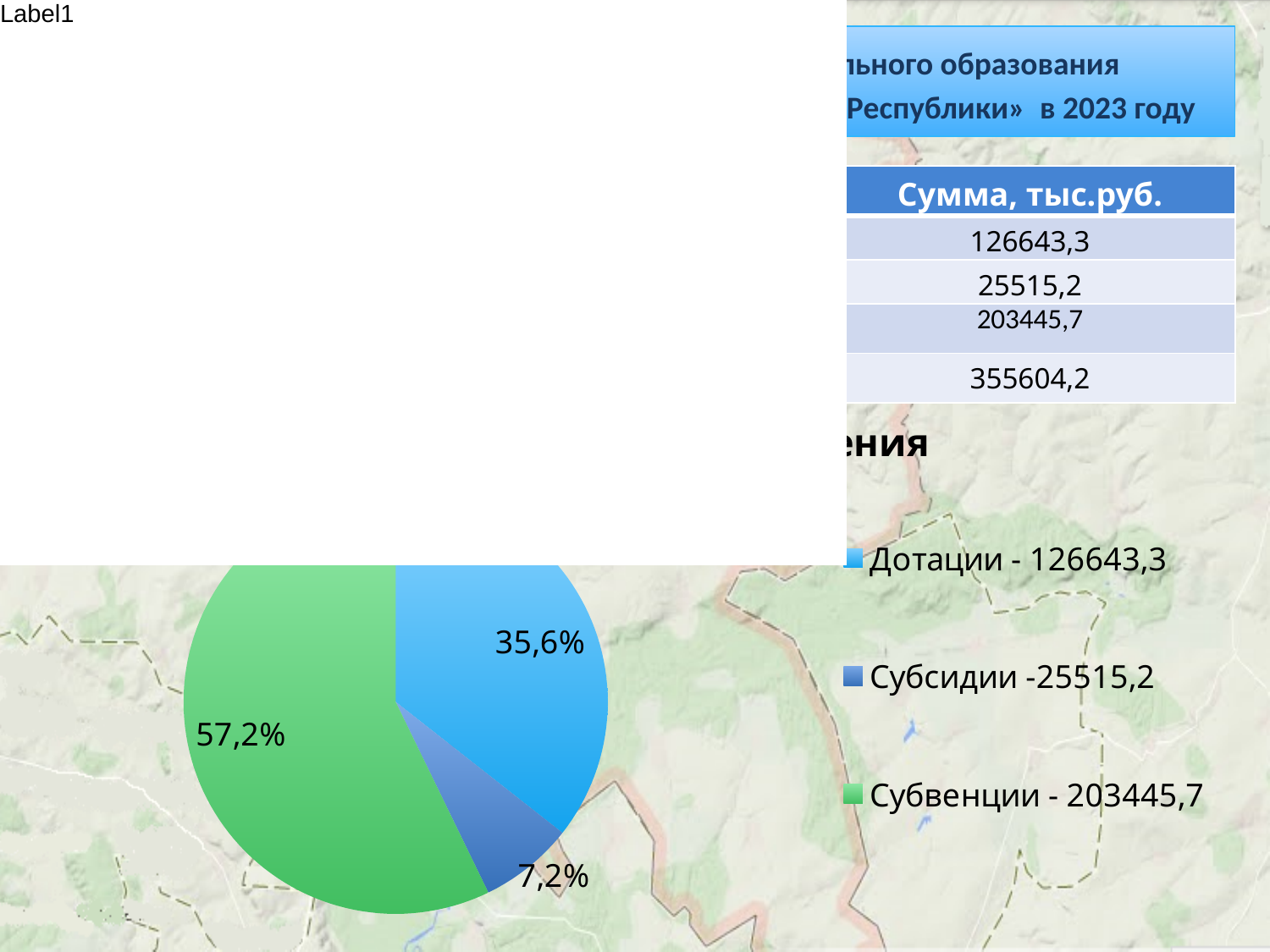
What percentage share does the Субсидии slice have in the pie chart? 7,2% What colour is the Субвенции slice in the pie chart? green What is the difference in percentage points between the Субвенции and Дотации slices? 21,6 How many entries does the legend of the pie chart list? 3 Which slice is larger in the pie chart, Дотации or Субсидии? Дотации Which category has the largest slice in the pie chart? Субвенции Which category has the smallest slice in the pie chart? Субсидии What value is shown next to Субвенции in the legend of the pie chart? 203445,7 What percentage share does the Дотации slice have in the pie chart? 35,6% How many slices does the pie chart have? 3 What kind of chart is shown on the slide? pie chart What percentage share does the Субвенции slice have in the pie chart? 57,2%